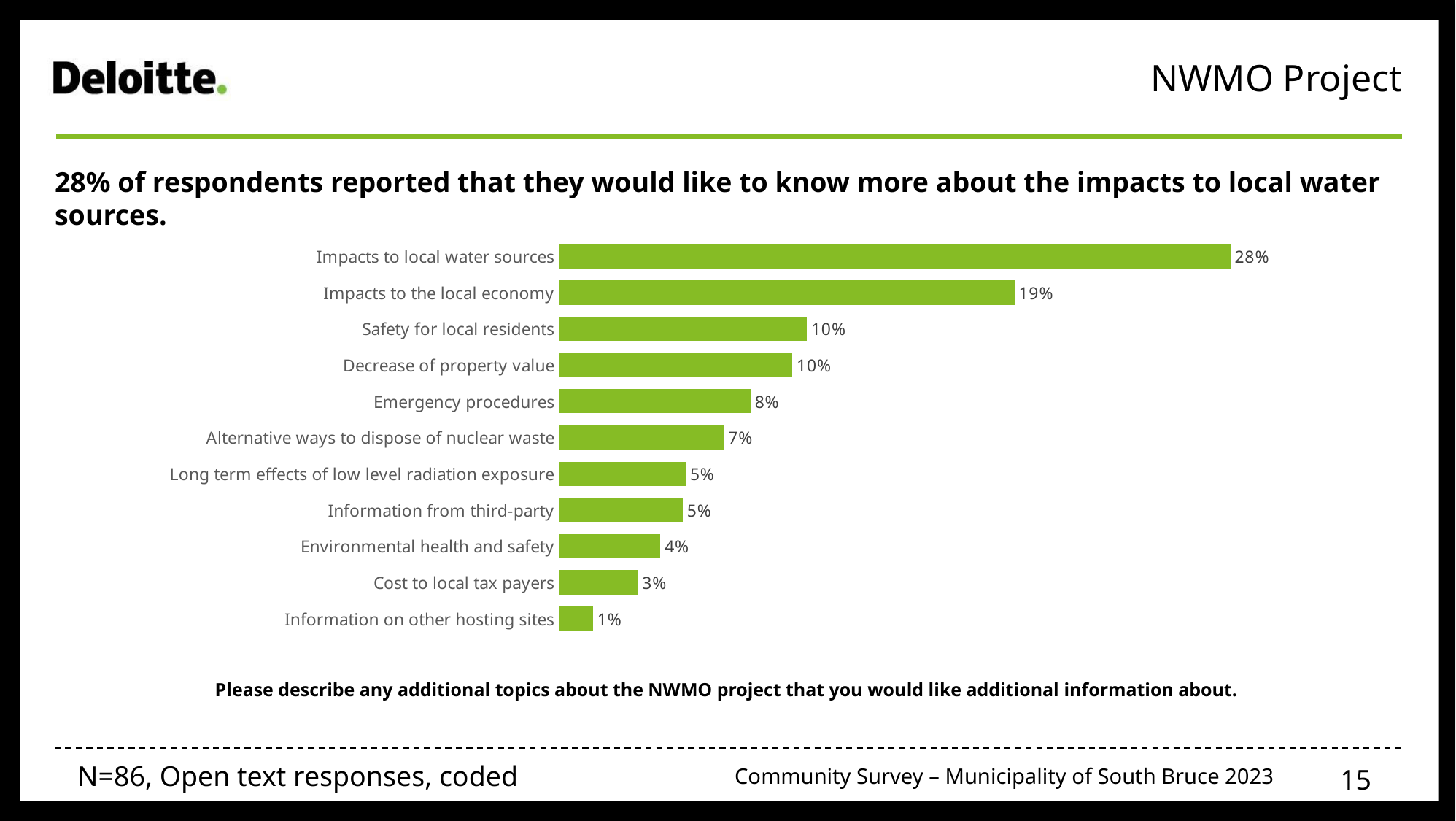
What colour are the bars in the chart? Green Which is larger, the value for Impacts to the local economy or the value for Safety for local residents? Impacts to the local economy What percentage of respondents would like to know more about impacts to local water sources? 28% What is the difference between the values for Impacts to local water sources and Impacts to the local economy? 9% What is the value for Alternative ways to dispose of nuclear waste? 7% Which topic has the lowest percentage of respondents? Information on other hosting sites What kind of chart is shown on the slide? Bar chart Which topic has the highest percentage of respondents? Impacts to local water sources What is the value for Cost to local tax payers? 3% What is the value for Emergency procedures? 8% What is the difference between the values for Safety for local residents and Environmental health and safety? 6% How many topics are shown in the chart? 11